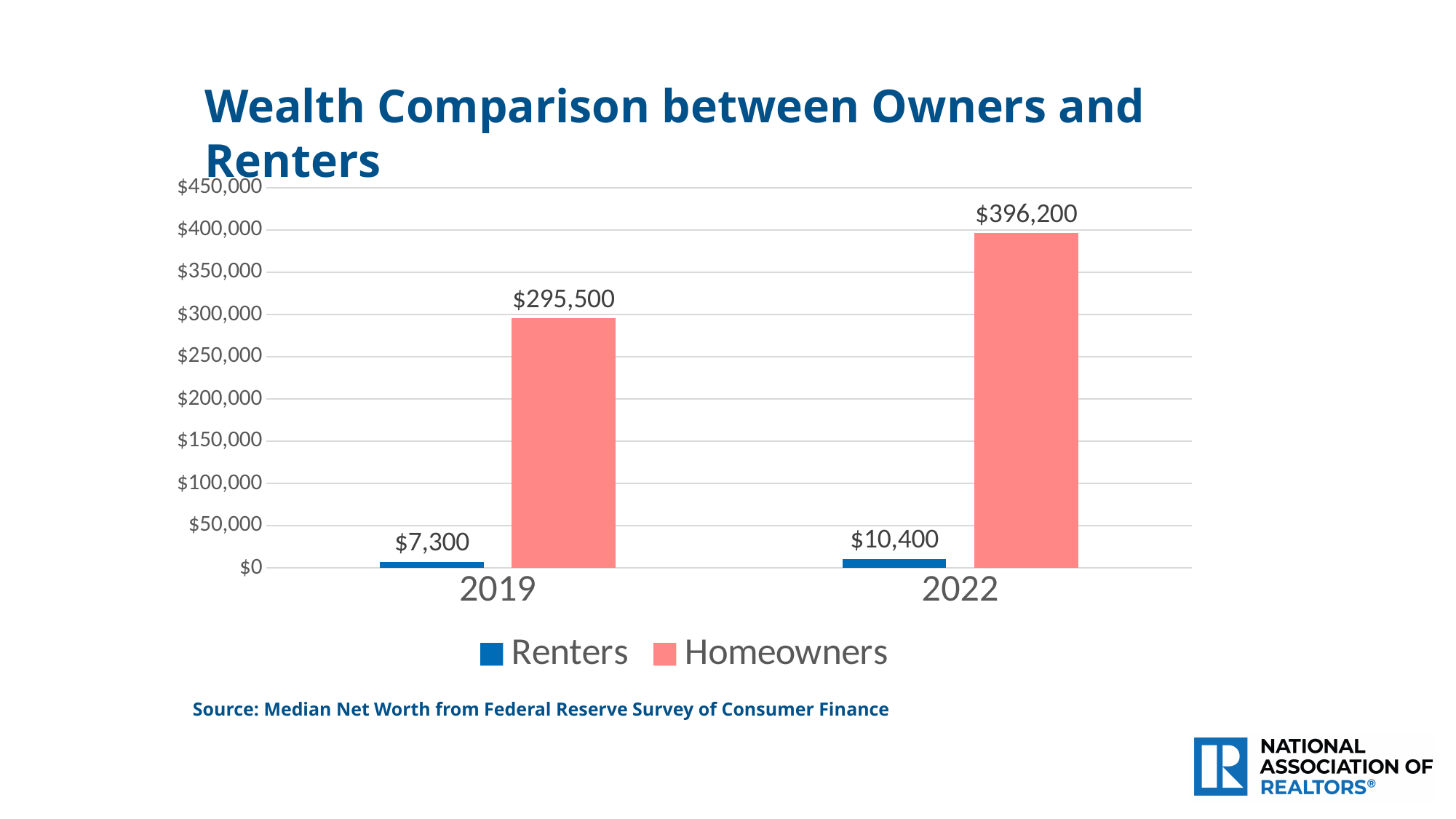
Which is larger: the Renters value in 2022 or the Renters value in 2019? Renters in 2022 What is the median net worth of Homeowners in 2022? $396,200 What is the difference between the Homeowners value in 2022 and the Homeowners value in 2019? $100,700 What is the median net worth of Renters in 2019? $7,300 Does the Renters value rise or fall from 2019 to 2022? Rise How many series does the legend list? 2 What is the median net worth of Homeowners in 2019? $295,500 What kind of chart is shown on the slide? Bar chart Which year shows the higher value for Homeowners? 2022 What is the difference between the Homeowners and Renters values in 2022? $385,800 What is the median net worth of Renters in 2022? $10,400 Which bar on the chart has the lowest value? Renters in 2019